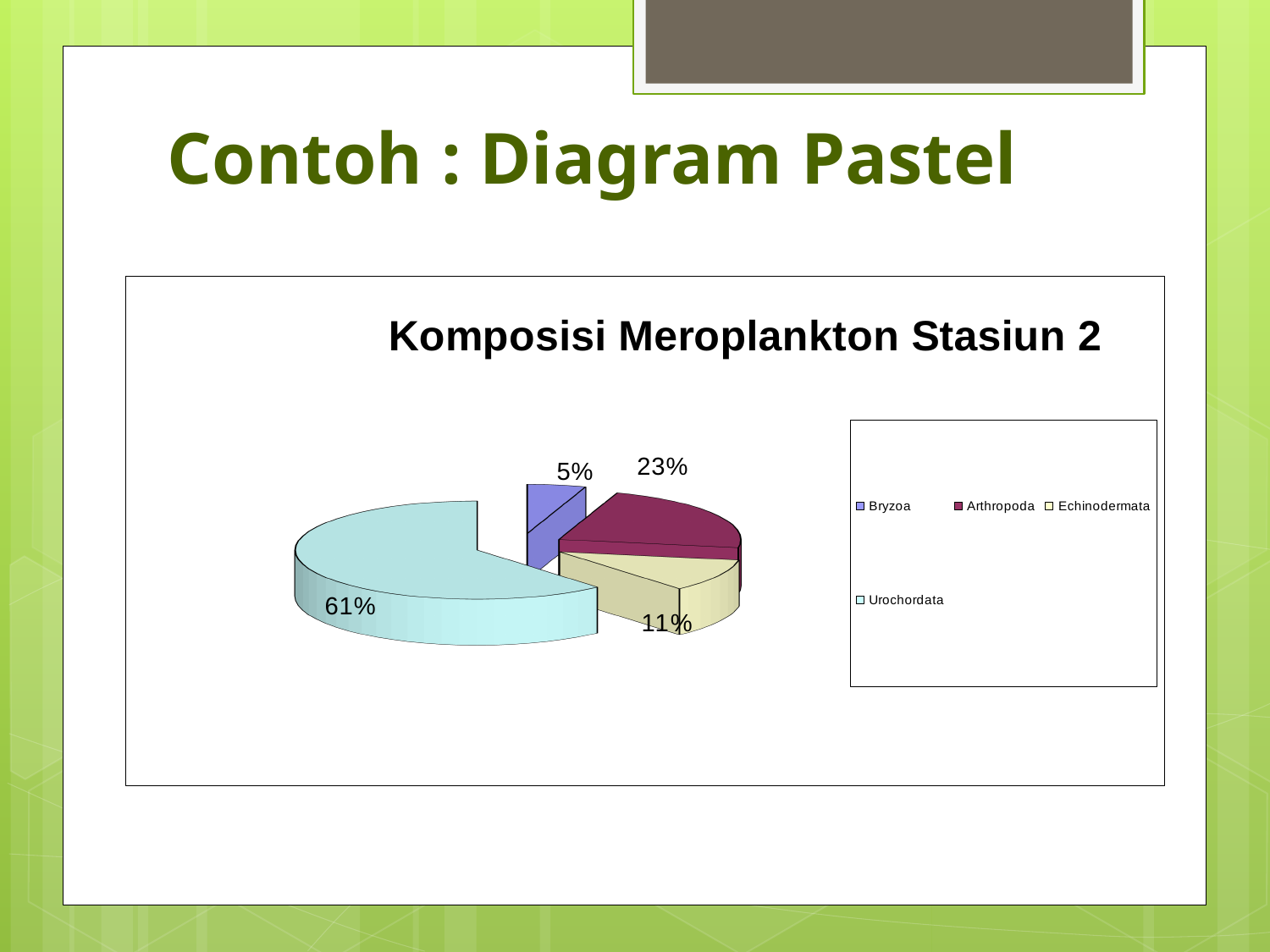
What share of the pie does Bryzoa have? 5% What share of the pie does Arthropoda have? 23% How many categories does the pie chart show? 4 What share of the pie does Echinodermata have? 11% What is the title of the chart? Komposisi Meroplankton Stasiun 2 Which is larger, the share for Arthropoda or the share for Echinodermata? Arthropoda Which category has the smallest slice of the pie? Bryzoa What kind of chart is shown on the slide? pie chart How many entries does the legend list? 4 What is the difference in percentage points between Urochordata and Arthropoda? 38 Which category has the largest slice of the pie? Urochordata